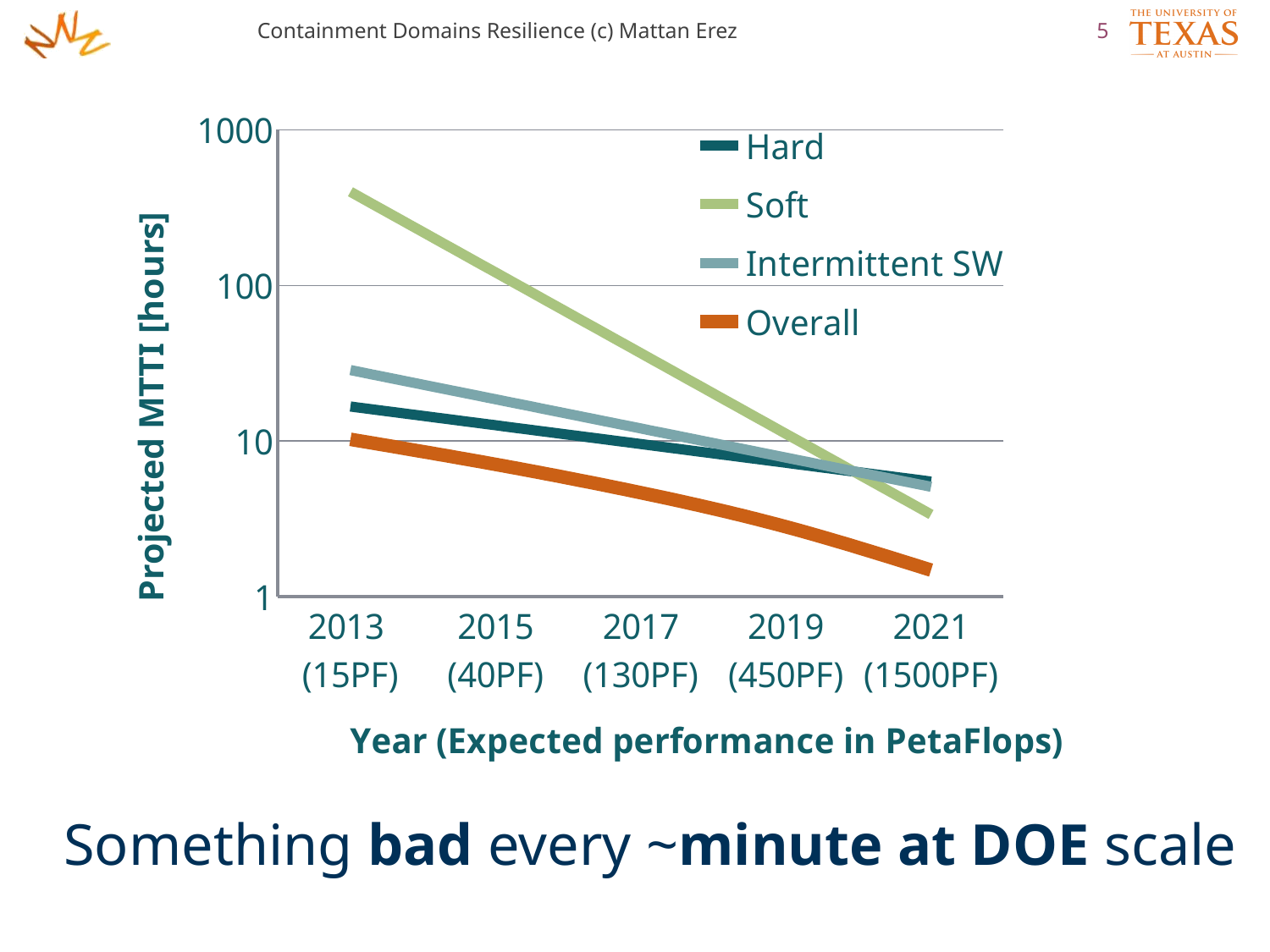
What kind of chart is shown on the slide? line chart Which series has the lowest projected MTTI in 2021? Overall Do the projected MTTI values rise or fall from 2013 to 2021? fall Is the value for Intermittent SW in 2013 greater or less than 10? greater What is the label of the y axis? Projected MTTI [hours] How many years are shown along the x axis? 5 Is the value for Soft in 2013 greater or less than 100? greater Which is larger in 2013, the value for Soft or the value for Overall? Soft Is the value for Overall in 2021 greater or less than 10? less Which series has the highest projected MTTI in 2013? Soft How many series does the legend list? 4 What expected performance in PetaFlops is listed under the year 2021? 1500PF